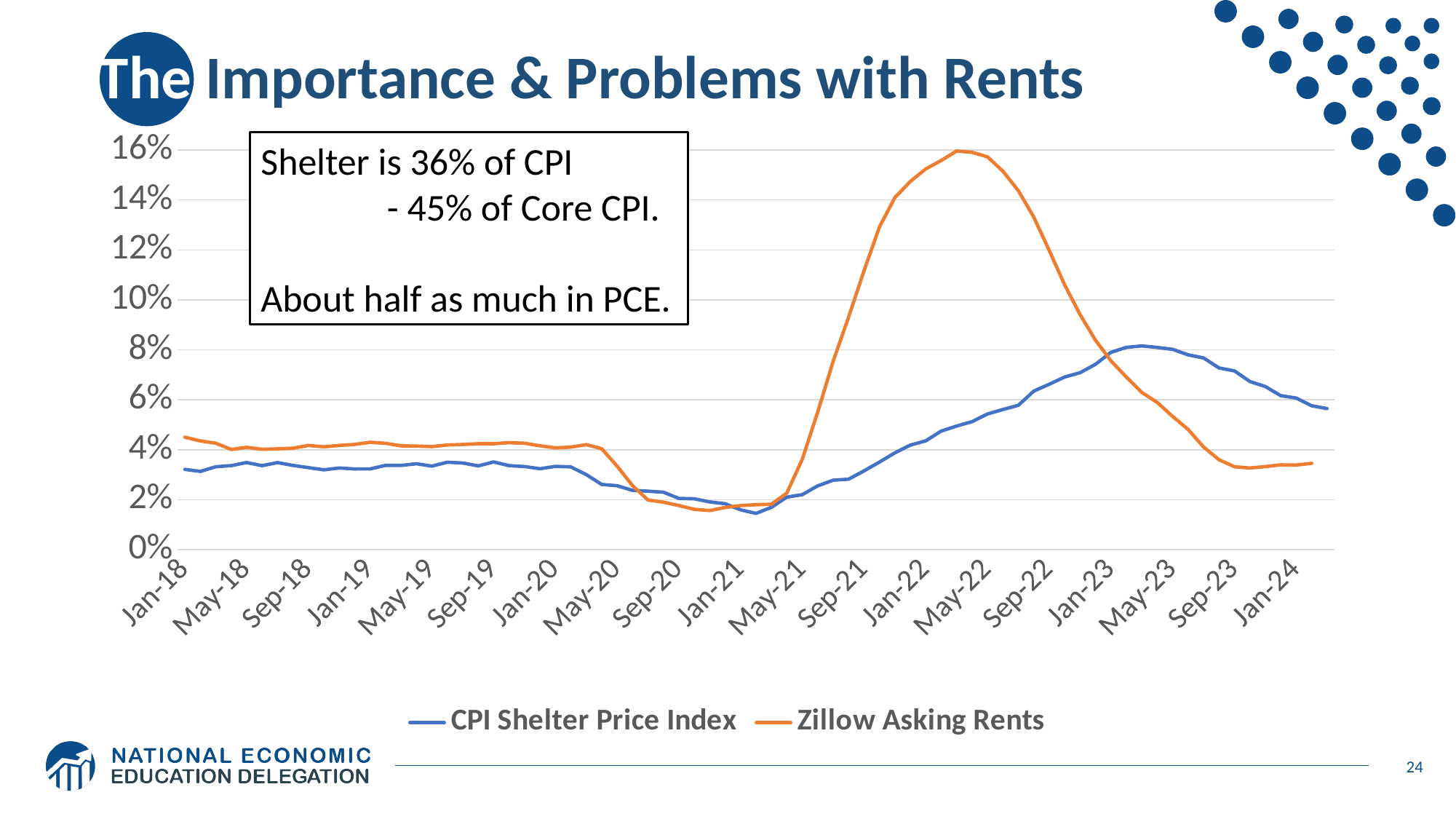
Which series reaches the highest value anywhere on the chart? Zillow Asking Rents Which colour is used for the Zillow Asking Rents line? Orange At May-23, which series has the higher value, CPI Shelter Price Index or Zillow Asking Rents? CPI Shelter Price Index How many series does the legend list? 2 Is the value for Zillow Asking Rents at May-22 greater or less than 14%? greater What kind of chart is shown on the slide? Line chart At May-22, which series has the higher value, CPI Shelter Price Index or Zillow Asking Rents? Zillow Asking Rents Is the value for Zillow Asking Rents at Jan-21 greater or less than 2%? less What are the two series named in the legend? CPI Shelter Price Index and Zillow Asking Rents Does the Zillow Asking Rents line rise or fall between May-22 and Sep-23? Fall How many date labels are shown along the x axis? 19 Is the value for CPI Shelter Price Index at Jan-18 greater or less than 4%? less